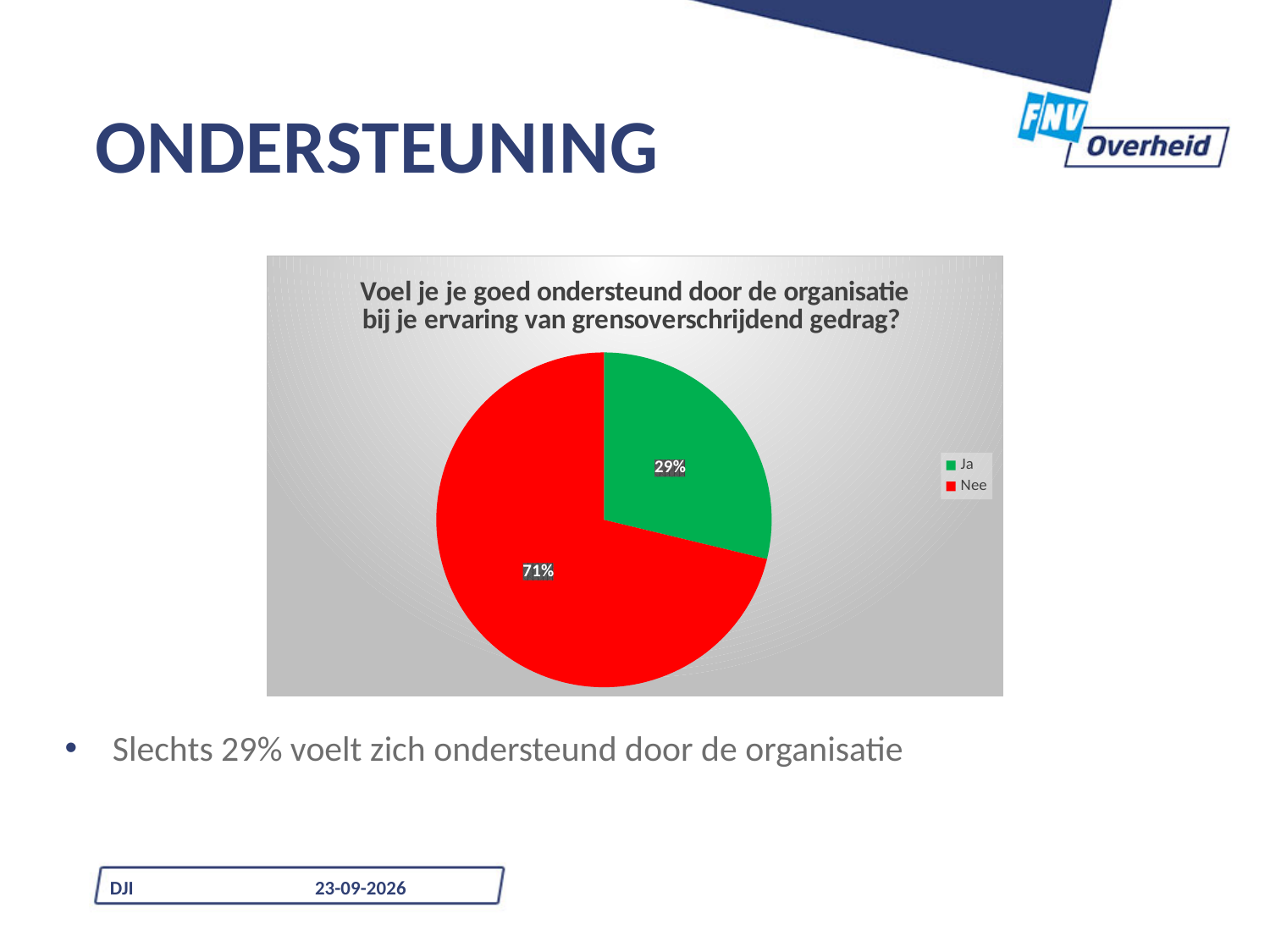
What colour is the "Nee" slice? red How many slices does the pie chart have? 2 What share of the pie does "Ja" represent? 29% Which category has the smallest slice of the pie? Ja What share of the pie does "Nee" represent? 71% What is the title of the chart? Voel je je goed ondersteund door de organisatie bij je ervaring van grensoverschrijdend gedrag? Which category has the largest slice of the pie? Nee How many entries does the legend list? 2 What kind of chart is shown on the slide? pie chart Which is larger, the "Ja" slice or the "Nee" slice? Nee What is the difference in percentage points between the "Nee" and "Ja" slices? 42